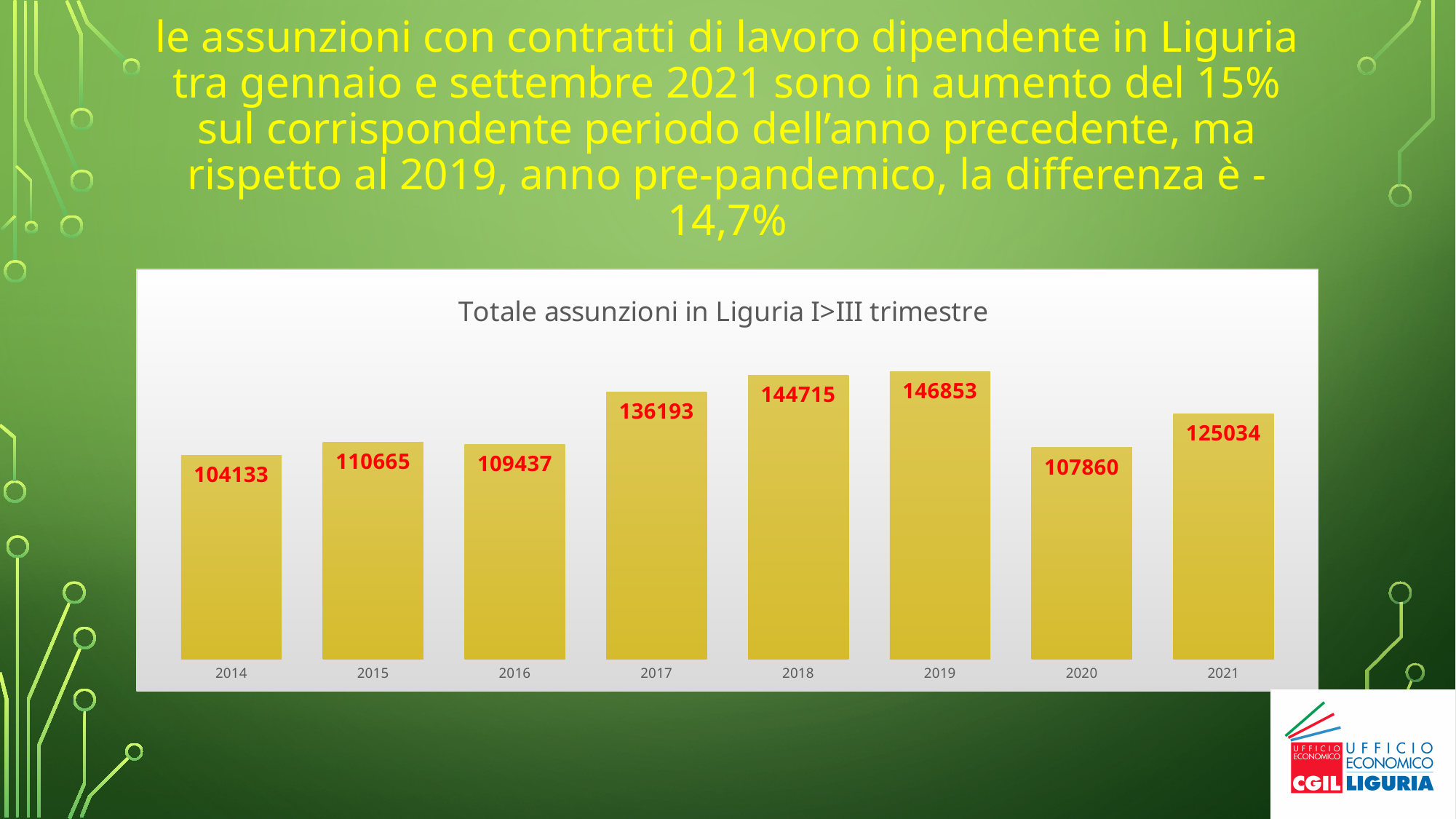
Do the values rise or fall from 2017 to 2019? rise Which year has the lowest value in the chart? 2014 Which is larger, the value for 2017 or the value for 2020? 2017 Which year has the highest value in the chart? 2019 What is the value for 2014 in the chart? 104133 How many years are shown in the chart? 8 What kind of chart is shown on the slide? bar chart What is the value for 2021 in the chart? 125034 What is the value for 2019 in the chart? 146853 What is the title of the chart? Totale assunzioni in Liguria I>III trimestre What is the difference between the values for 2019 and 2021? 21819 What is the difference between the values for 2021 and 2020? 17174